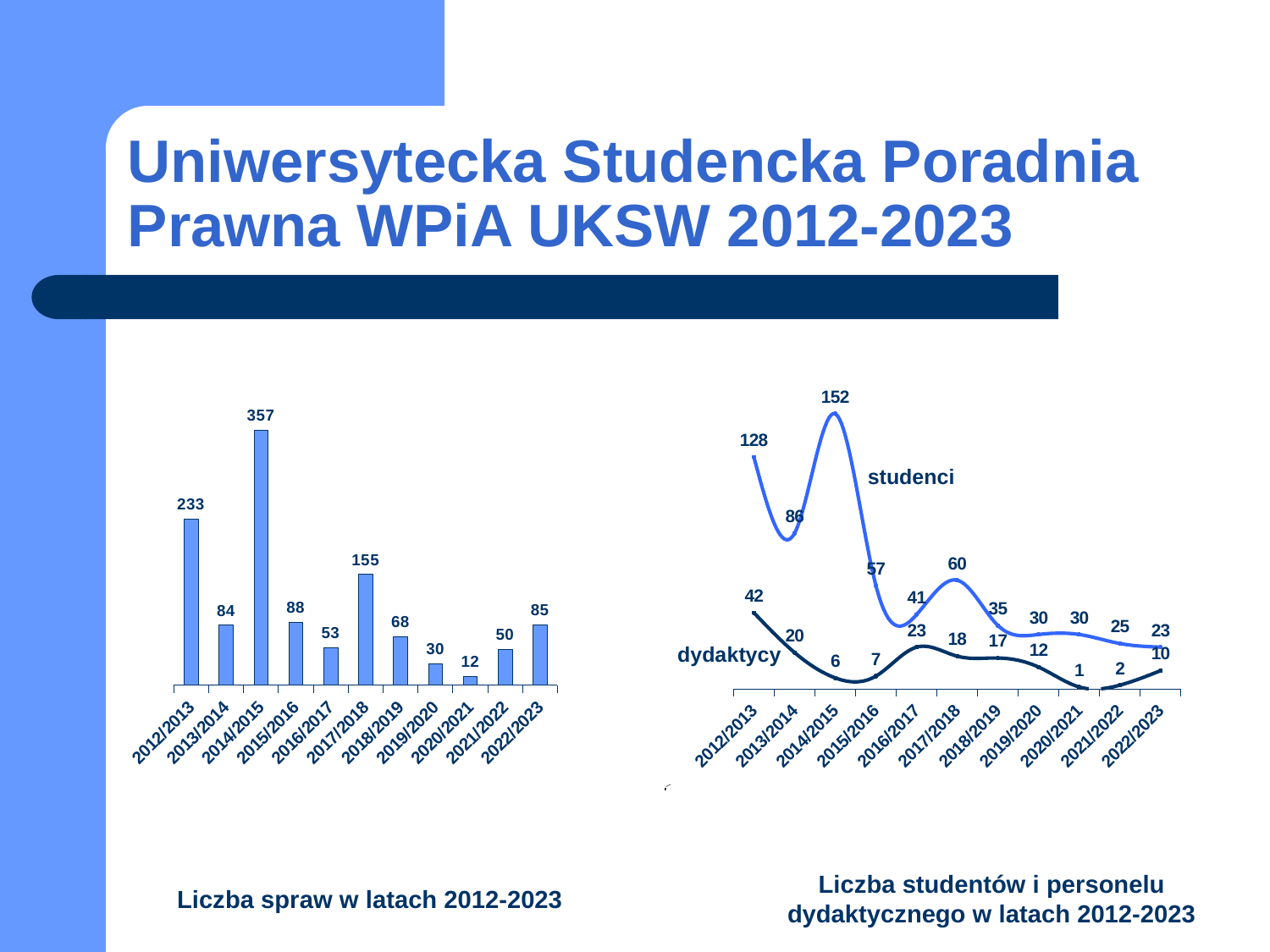
In the left chart (Liczba spraw w latach 2012-2023), what is the value for 2014/2015? 357 In the left chart (Liczba spraw w latach 2012-2023), which is larger, the value for 2017/2018 or the value for 2022/2023? 2017/2018 In the left chart (Liczba spraw w latach 2012-2023), which year has the lowest value? 2020/2021 What kind of chart is the right chart (Liczba studentów i personelu dydaktycznego)? line chart In the left chart (Liczba spraw w latach 2012-2023), how many years are shown on the x axis? 11 In the right chart (Liczba studentów i personelu dydaktycznego), what is the difference between studenci and dydaktycy in 2022/2023? 13 In the right chart (Liczba studentów i personelu dydaktycznego), which year has the highest value for dydaktycy? 2012/2013 In the right chart (Liczba studentów i personelu dydaktycznego), what is the value for dydaktycy in 2020/2021? 1 What kind of chart is the left chart (Liczba spraw w latach 2012-2023)? bar chart In the right chart (Liczba studentów i personelu dydaktycznego), how many series are plotted? 2 In the left chart (Liczba spraw w latach 2012-2023), what is the difference between the values for 2012/2013 and 2013/2014? 149 In the right chart (Liczba studentów i personelu dydaktycznego), what is the value for studenci in 2014/2015? 152